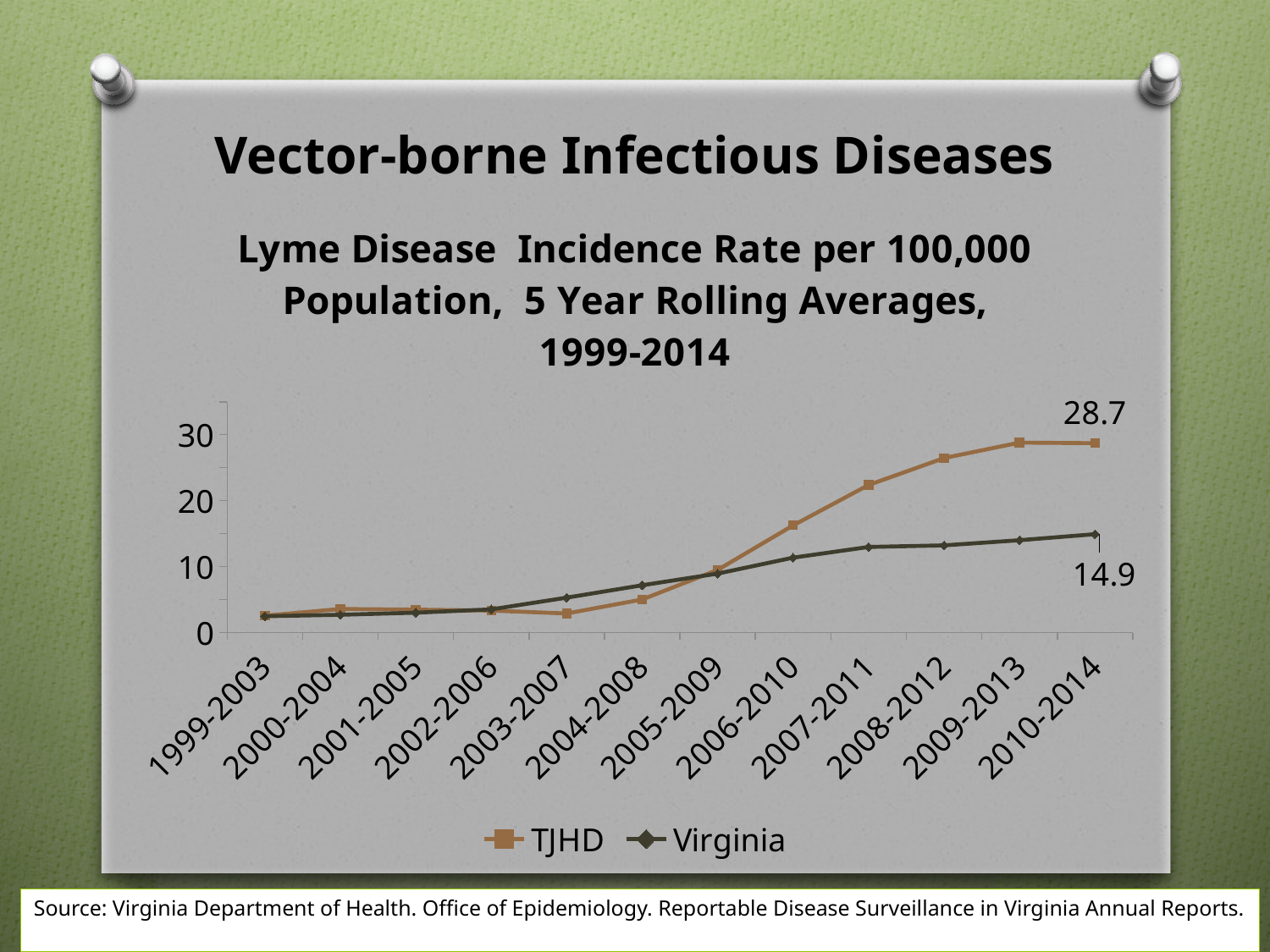
What kind of chart is shown on the slide? line chart What is the difference between the TJHD and Virginia rates for 2010-2014? 13.8 Is the TJHD value for 2003-2007 greater or less than 10? less What is the TJHD Lyme disease incidence rate for the 2010-2014 period? 28.7 Is the Virginia value for 2007-2011 greater or less than 10? greater Which series has the higher value for 2010-2014, TJHD or Virginia? TJHD Does the TJHD series generally rise or fall from 1999-2003 to 2010-2014? rise How many 5-year periods are shown on the x axis? 12 Which series has the higher value for 2006-2010, TJHD or Virginia? TJHD How many series does the legend list? 2 What is the Virginia Lyme disease incidence rate for the 2010-2014 period? 14.9 Is the TJHD value for 2008-2012 greater or less than 20? greater